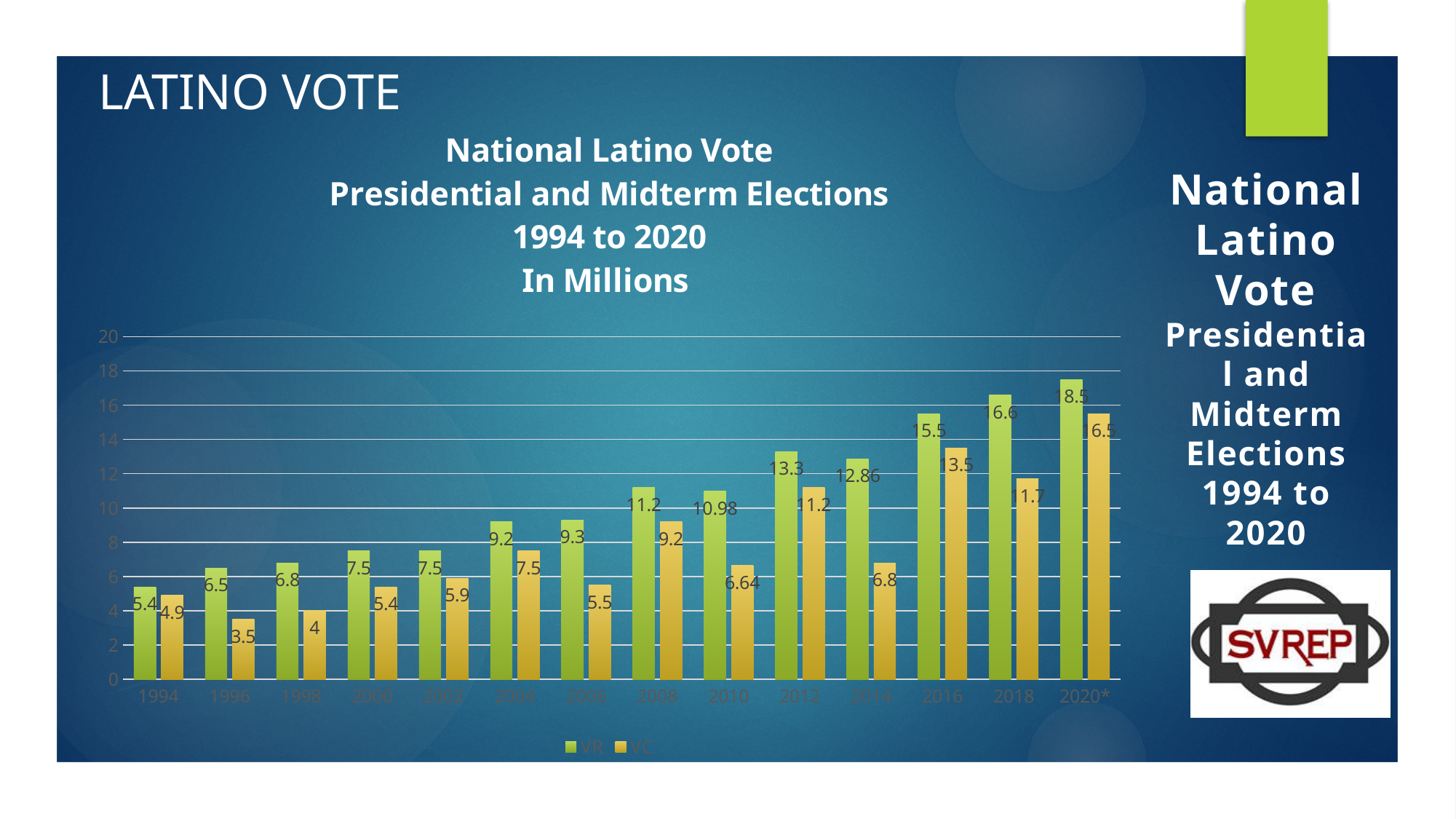
What is the VR value for 2012? 13.3 What is the VC value for 2010? 6.64 What is the VR value for 2014? 12.86 What kind of chart is shown on the slide? Bar chart How many series does the legend list? 2 What is the VC value for 1996? 3.5 Which year has the lowest VC value? 1996 What are the two series named in the legend? VR and VC Which year has the highest VR value? 2020* What is the difference between the VR and VC values for 2014? 6.06 How many years are shown on the x axis? 14 Which is larger, the VC value for 2016 or the VC value for 2018? 2016